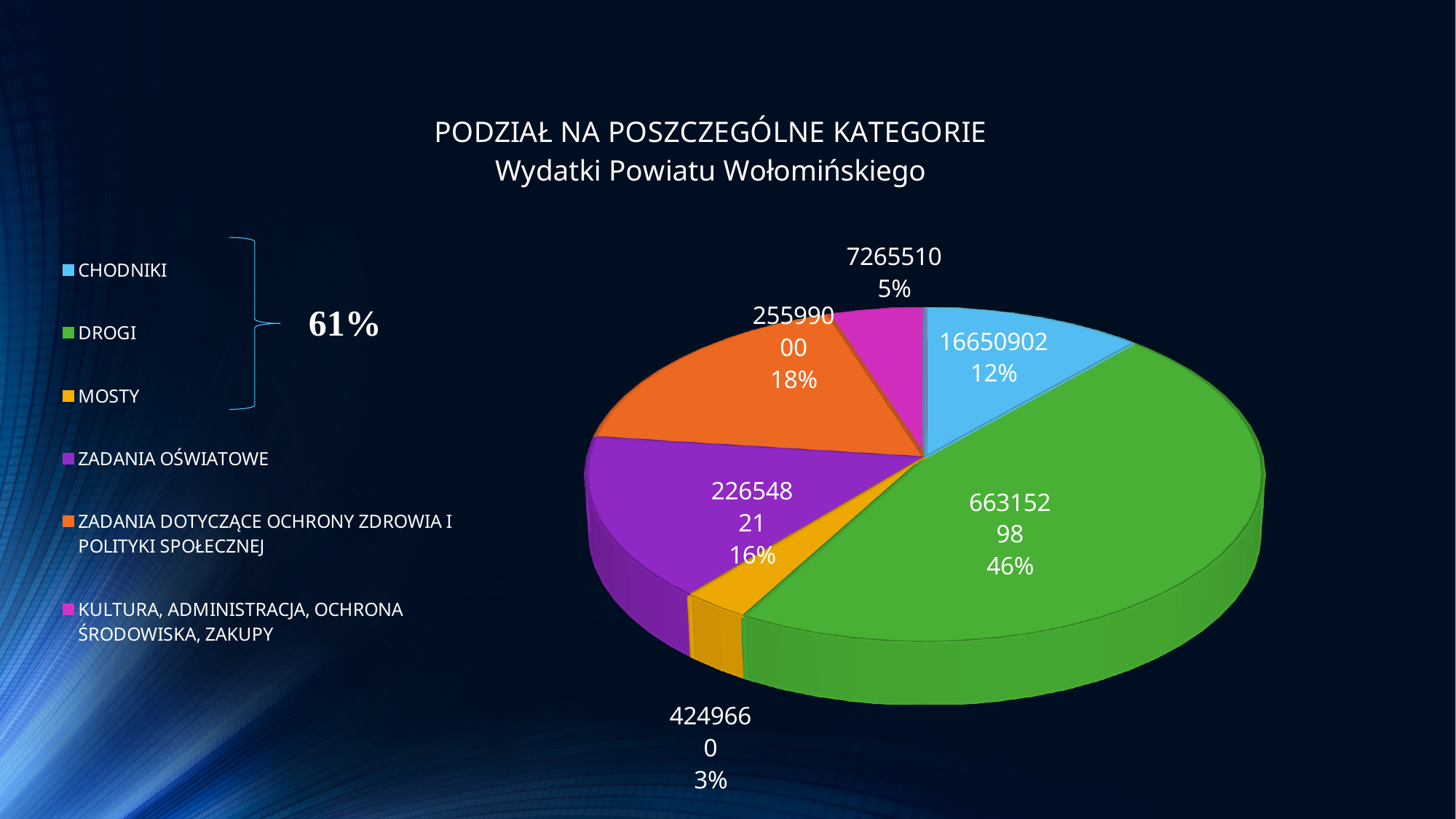
What percentage share does DROGI have in the pie chart? 46% Which category has the largest slice in the pie chart? DROGI What percentage share does ZADANIA OŚWIATOWE have in the pie chart? 16% How many categories does the legend of the pie chart list? 6 What percentage share does CHODNIKI have in the pie chart? 12% What kind of chart is shown on the slide? pie chart What value is shown for CHODNIKI in the pie chart? 16650902 Which has a larger share: ZADANIA OŚWIATOWE or CHODNIKI? ZADANIA OŚWIATOWE What value is shown for KULTURA, ADMINISTRACJA, OCHRONA ŚRODOWISKA, ZAKUPY in the pie chart? 7265510 Which category has the smallest slice in the pie chart? MOSTY